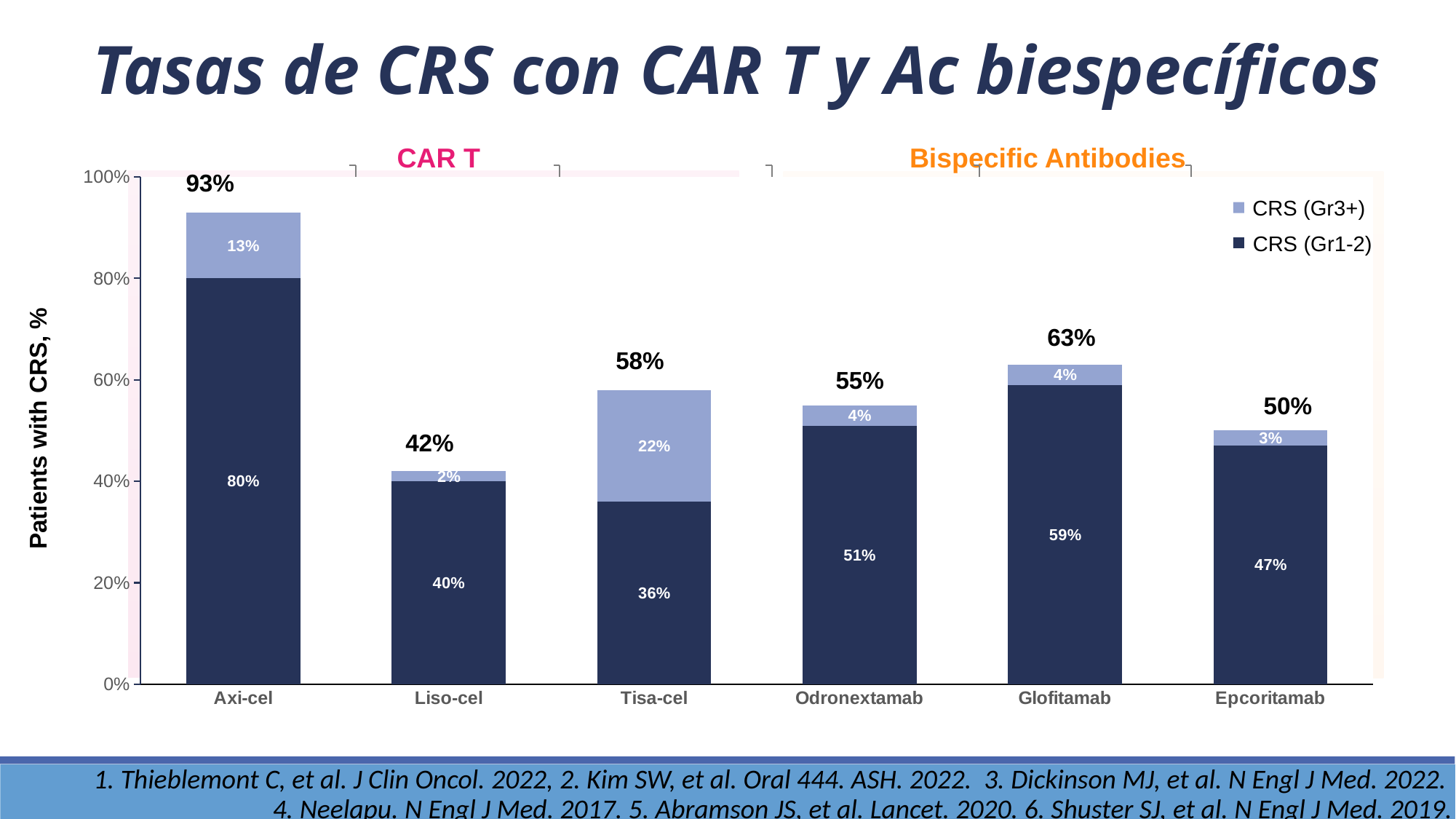
What is the CRS (Gr1-2) value for Axi-cel? 80% How many categories are shown on the x axis? 6 What is the difference between the total CRS rates of Axi-cel and Liso-cel? 51% What kind of chart is shown on the slide? Stacked bar chart Which category has the lowest total CRS rate? Liso-cel What is the label of the y axis? Patients with CRS, % Which category has the highest total CRS rate? Axi-cel How many series does the legend list? 2 What is the total CRS rate shown above the Odronextamab bar? 55% What is the CRS (Gr3+) value for Tisa-cel? 22% What is the CRS (Gr1-2) value for Glofitamab? 59% Which has a larger CRS (Gr3+) value, Tisa-cel or Epcoritamab? Tisa-cel